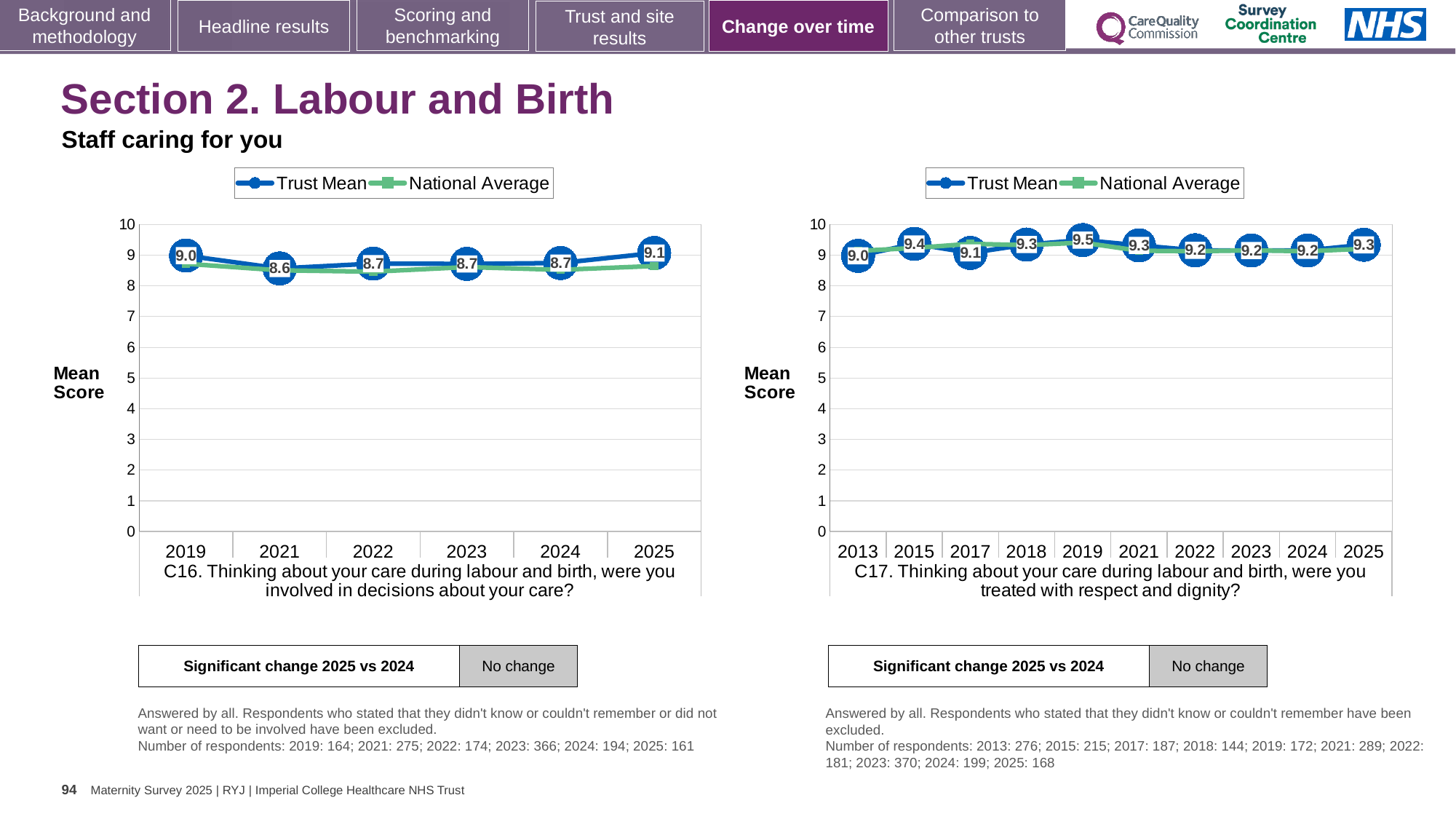
In the C16 chart (left), what is the Trust Mean for 2025? 9.1 What type of chart is the C17 chart (right)? Line chart In the C17 chart (right), which year has the highest Trust Mean? 2019 In the C17 chart (right), what is the Trust Mean for 2019? 9.5 In the C17 chart (right), is the Trust Mean for 2015 larger or smaller than for 2017? larger In the C16 chart (left), what is the difference between the Trust Mean for 2025 and 2021? 0.5 In the C16 chart (left), which year has the lowest Trust Mean? 2021 In the C17 chart (right), what is the Trust Mean for 2013? 9.0 In the C16 chart (left), what is the Trust Mean for 2021? 8.6 In the C16 chart (left), how many years are shown on the x axis? 6 In the C17 chart (right), how many years are shown on the x axis? 10 How many series does the legend of the C16 chart (left) list? 2